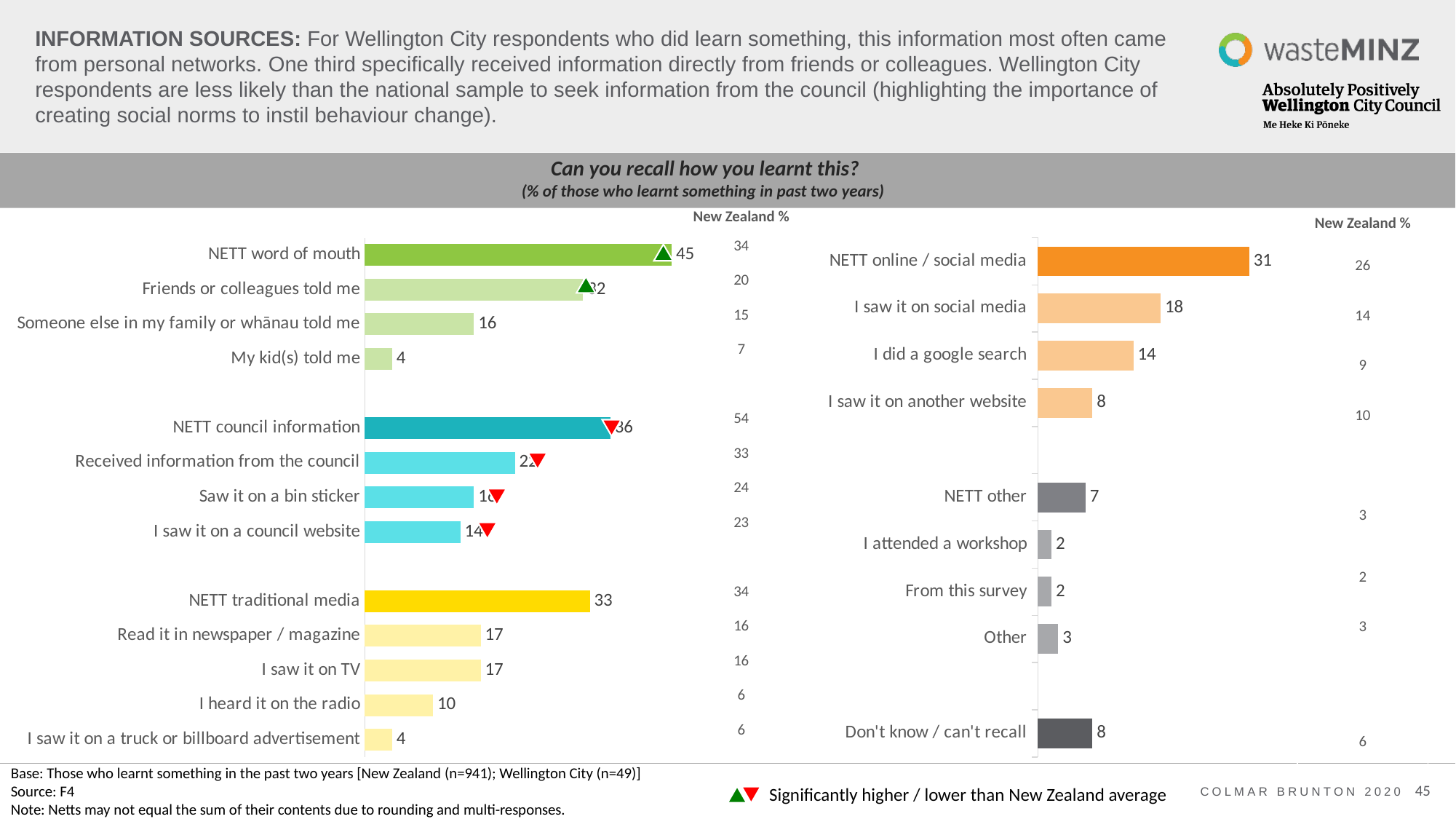
In the left chart, what is the difference between 'NETT traditional media' and 'Read it in newspaper / magazine'? 16 In the left chart, what is the value for 'I heard it on the radio'? 10 In the right chart, what is the difference between 'I saw it on social media' and 'I saw it on another website'? 10 How many categories are plotted in the right chart? 9 In the left chart, what is the value for 'NETT word of mouth'? 45 In the left chart, which is larger: 'NETT council information' or 'NETT traditional media'? NETT council information In the right chart, which category has the highest value? NETT online / social media In the left chart, which category has the highest value? NETT word of mouth In the right chart, what is the value for 'I did a google search'? 14 In the right chart, what is the value for 'Don't know / can't recall'? 8 What type of chart is used on the left side of the slide? Bar chart In the right chart, which is larger: 'NETT other' or 'Other'? NETT other